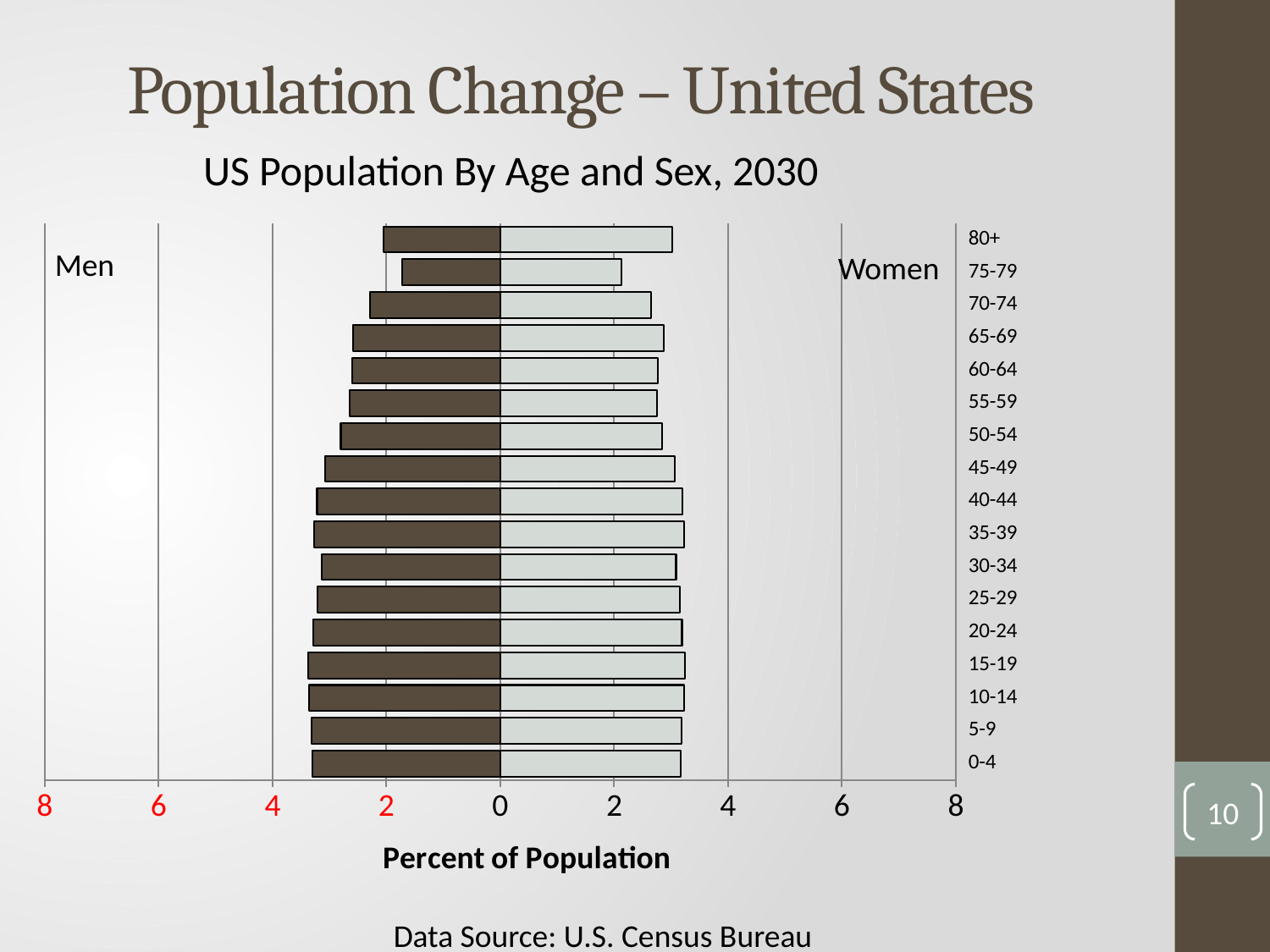
Is the value for Men aged 0-4 greater or less than 4? less Is the value for Women aged 80+ greater or less than 2? greater Is the value for Women aged 0-4 greater or less than 2? greater Which age group has the smallest value for Men? 75-79 How many series (sexes) does the chart show? 2 What is the title of the chart? US Population By Age and Sex, 2030 What kind of chart is shown on the slide? bar chart Which age group has the smallest value for Women? 75-79 What is the label on the horizontal axis of the chart? Percent of Population How many age groups are shown in the chart? 17 For the 80+ age group, which is larger, the value for Men or for Women? Women